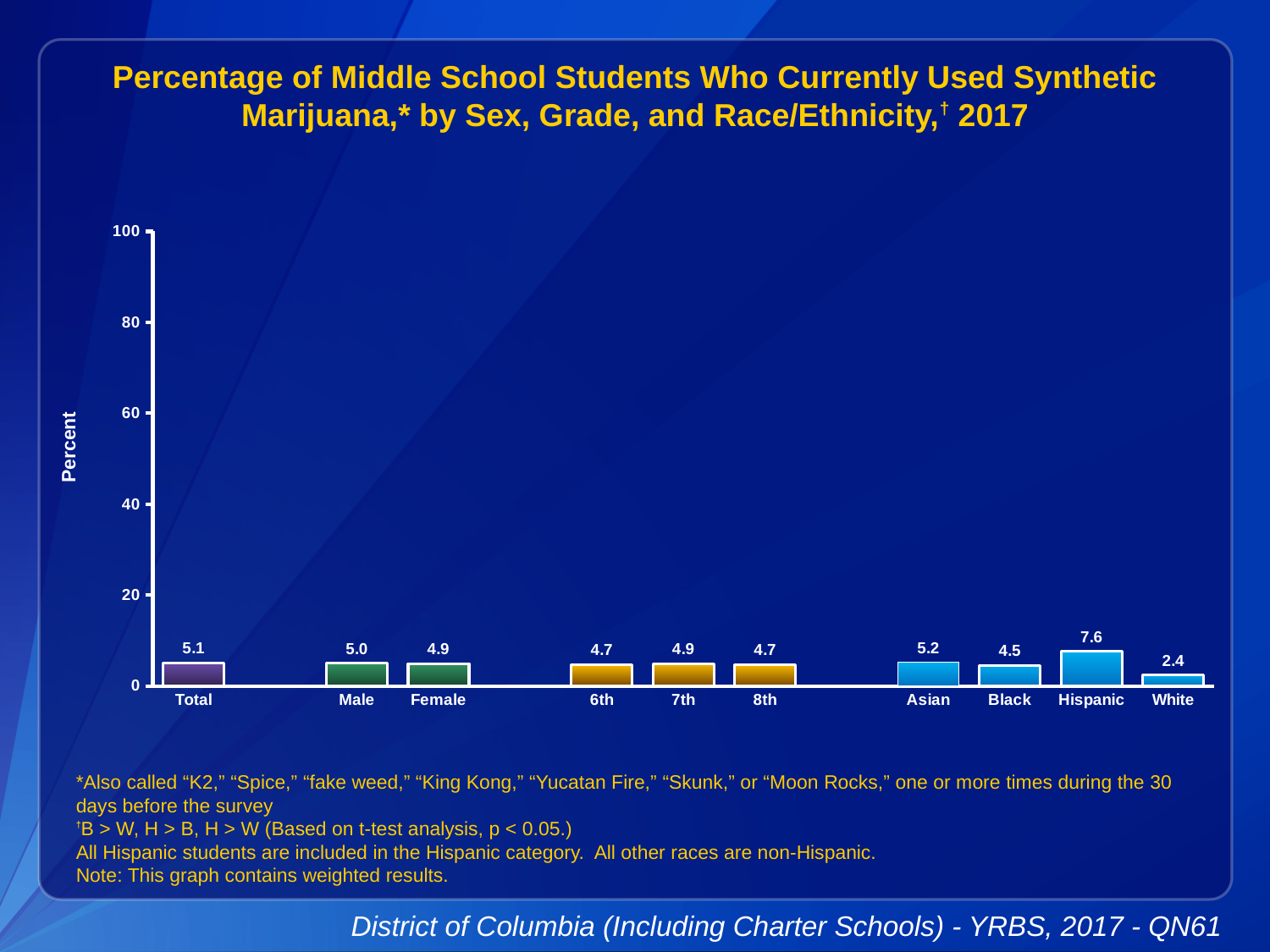
What is the value for 7th grade? 4.9 What is the difference between the Hispanic and White values? 5.2 What kind of chart is this? bar chart Which category has the highest value? Hispanic What is the value for White students? 2.4 What is the value for Hispanic students? 7.6 Is the value for Hispanic greater or less than 20? less How many categories are shown on the x axis? 10 What is the difference between the Male and Female values? 0.1 Which is larger, the value for Asian or the value for Black? Asian What is the value for Total? 5.1 Which category has the lowest value? White